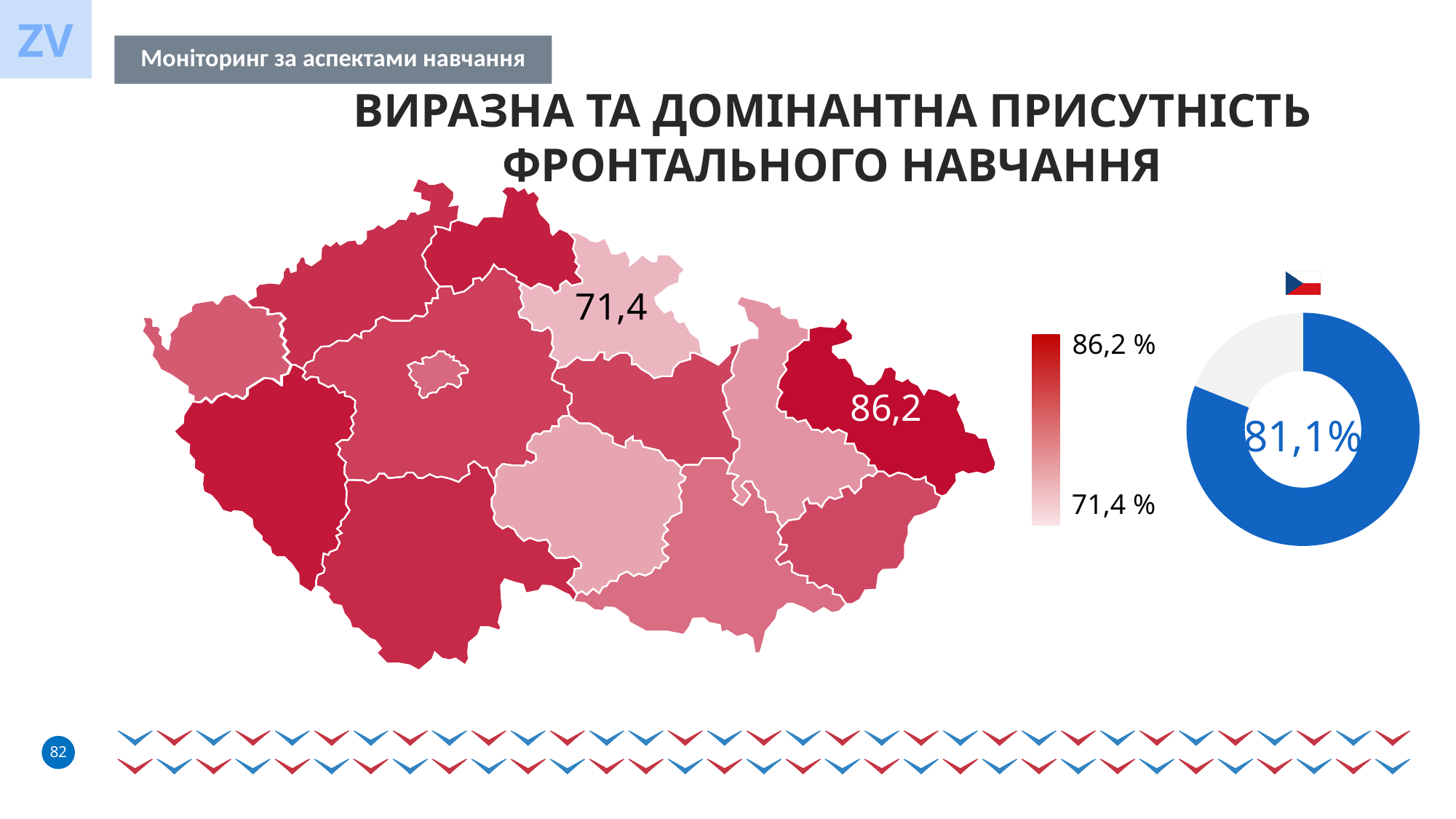
What colour is the filled portion of the donut chart? Blue Is the value labelled on the darkest region of the map greater or less than 85? greater What is the highest value shown on the map's colour scale? 86,2 % What colour represents the highest values on the map's colour scale? Dark red What kind of chart is shown on the right side of the slide? Donut chart What is the lowest value shown on the map's colour scale? 71,4 % On the donut chart on the right, what percentage is shown in the centre? 81,1% Is the value shown in the donut chart greater or less than 80%? greater What is the difference between the highest and lowest values on the map's colour scale? 14,8 What kind of chart is shown on the left side of the slide? Map (choropleth) Is the value labelled on the lightest region of the map greater or less than 75? less Which value labelled on the map is larger, 71,4 or 86,2? 86,2